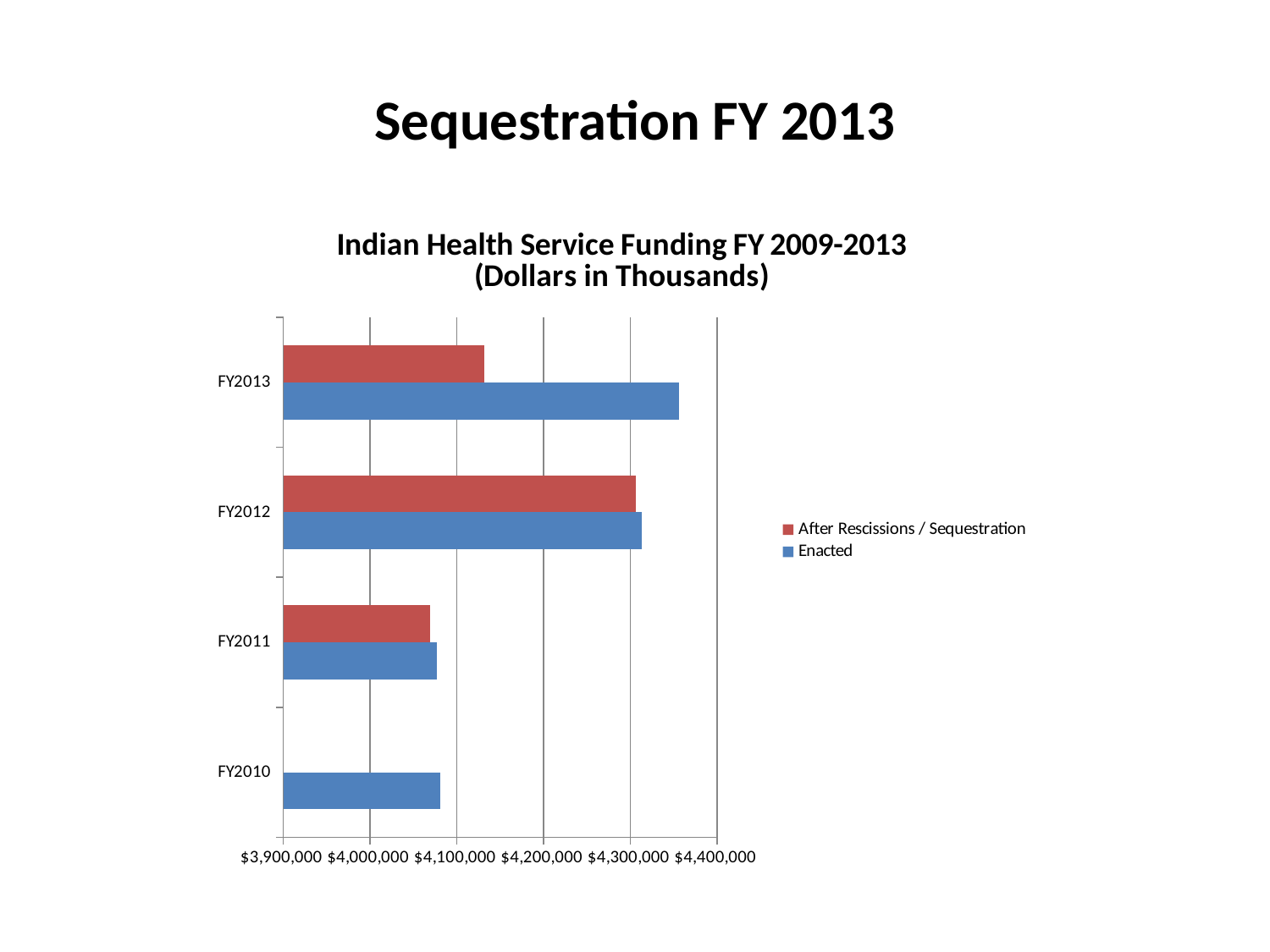
Is the Enacted value for FY2013 greater or less than $4,300,000? greater Which fiscal year has the highest After Rescissions / Sequestration value? FY2012 Which fiscal year has the highest Enacted value? FY2013 Which is larger: the After Rescissions / Sequestration value for FY2012 or for FY2013? FY2012 How many fiscal years are shown on the vertical axis? 4 What kind of chart is shown on the slide? bar chart For FY2013, which is larger: the Enacted value or the After Rescissions / Sequestration value? Enacted What is the title of the chart? Indian Health Service Funding FY 2009-2013 (Dollars in Thousands) Is the After Rescissions / Sequestration value for FY2013 greater or less than $4,200,000? less Is the Enacted value for FY2011 greater or less than $4,100,000? less Which fiscal year has the lowest After Rescissions / Sequestration value among those with a bar for that series? FY2011 How many series does the legend list? 2